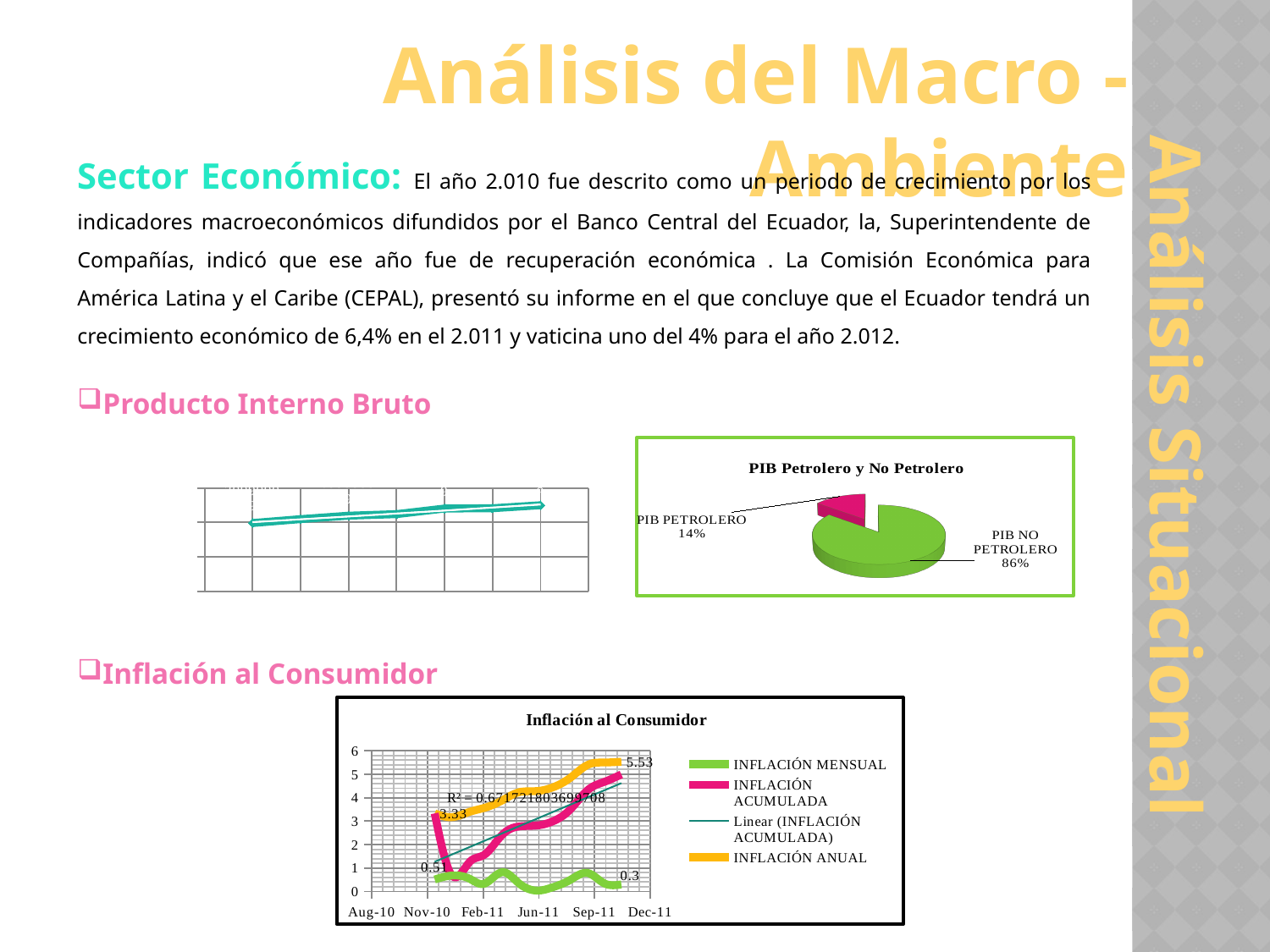
How many series does the legend of the 'Inflación al Consumidor' chart list? 4 In the 'Inflación al Consumidor' chart, what is the last labelled value of the INFLACIÓN ANUAL series? 5.53 In the 'Inflación al Consumidor' chart, does the INFLACIÓN ANUAL series rise or fall from left to right? Rises What kind of chart is 'PIB Petrolero y No Petrolero'? Pie chart In the 'Inflación al Consumidor' chart, which series is highest at the right end of the chart? INFLACIÓN ANUAL In the pie chart 'PIB Petrolero y No Petrolero', which slice is larger, PIB PETROLERO or PIB NO PETROLERO? PIB NO PETROLERO In the pie chart 'PIB Petrolero y No Petrolero', what share does PIB NO PETROLERO have? 86% What kind of chart is 'Inflación al Consumidor'? Line chart How many slices does the pie chart 'PIB Petrolero y No Petrolero' have? 2 In the pie chart 'PIB Petrolero y No Petrolero', what share does PIB PETROLERO have? 14% In the 'Inflación al Consumidor' chart, what is the difference between the labelled values 5.53 and 3.33 on the INFLACIÓN ANUAL series? 2.2